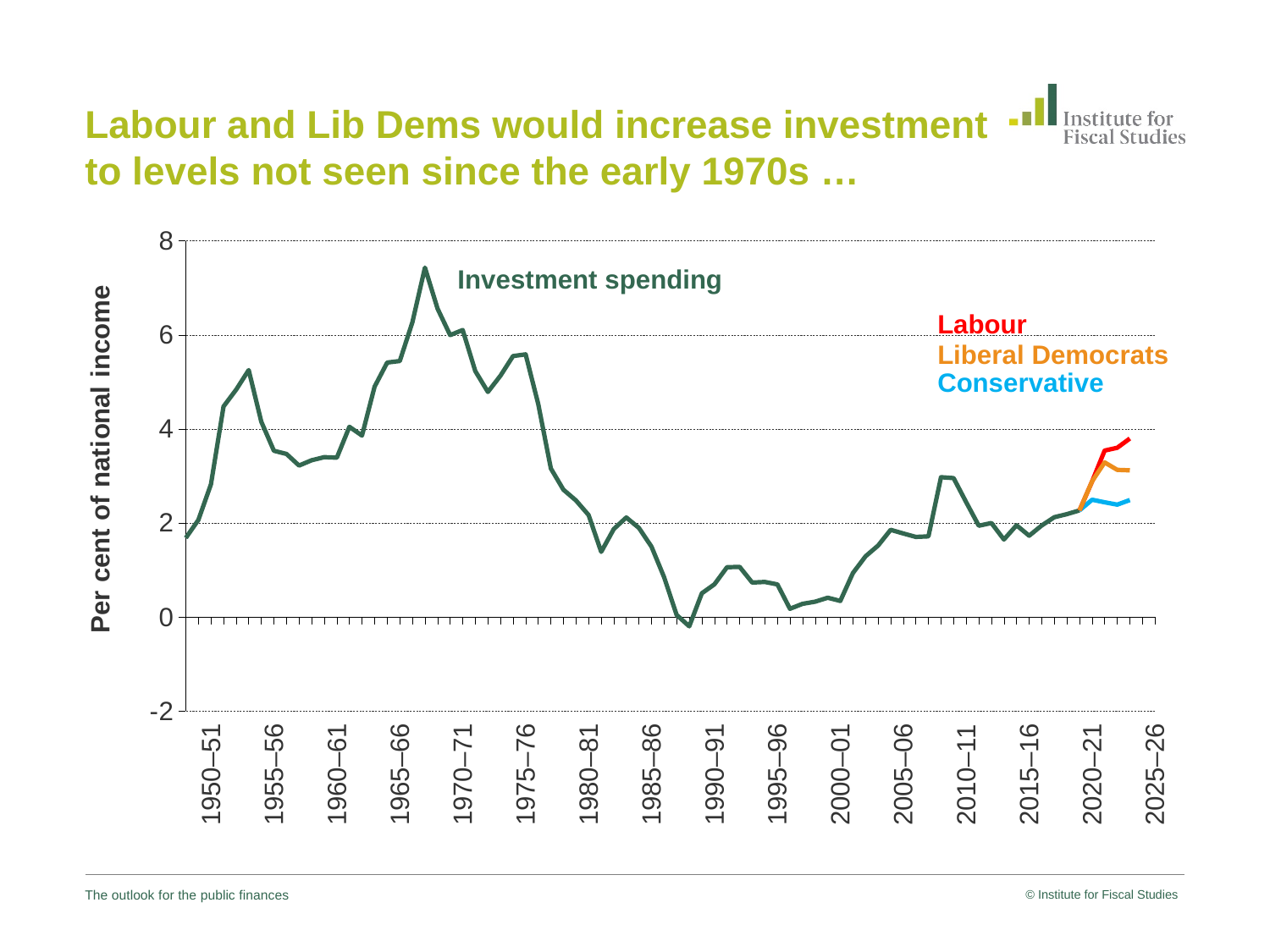
By 2025–26, is the Labour projection or the Conservative projection higher? Labour Is the value of investment spending in 1950–51 greater or less than 2? greater What is the label on the vertical axis? Per cent of national income Which party's projection is lowest by 2025–26? Conservative Is the peak value of investment spending in the late 1960s greater or less than 7? greater How many party projections are labelled on the chart? 3 Which party's projection is highest by 2025–26? Labour Which colour is used for the Labour projection line? red What kind of chart is shown on the slide? line chart Does investment spending rise or fall between 1975–76 and 1985–86? fall